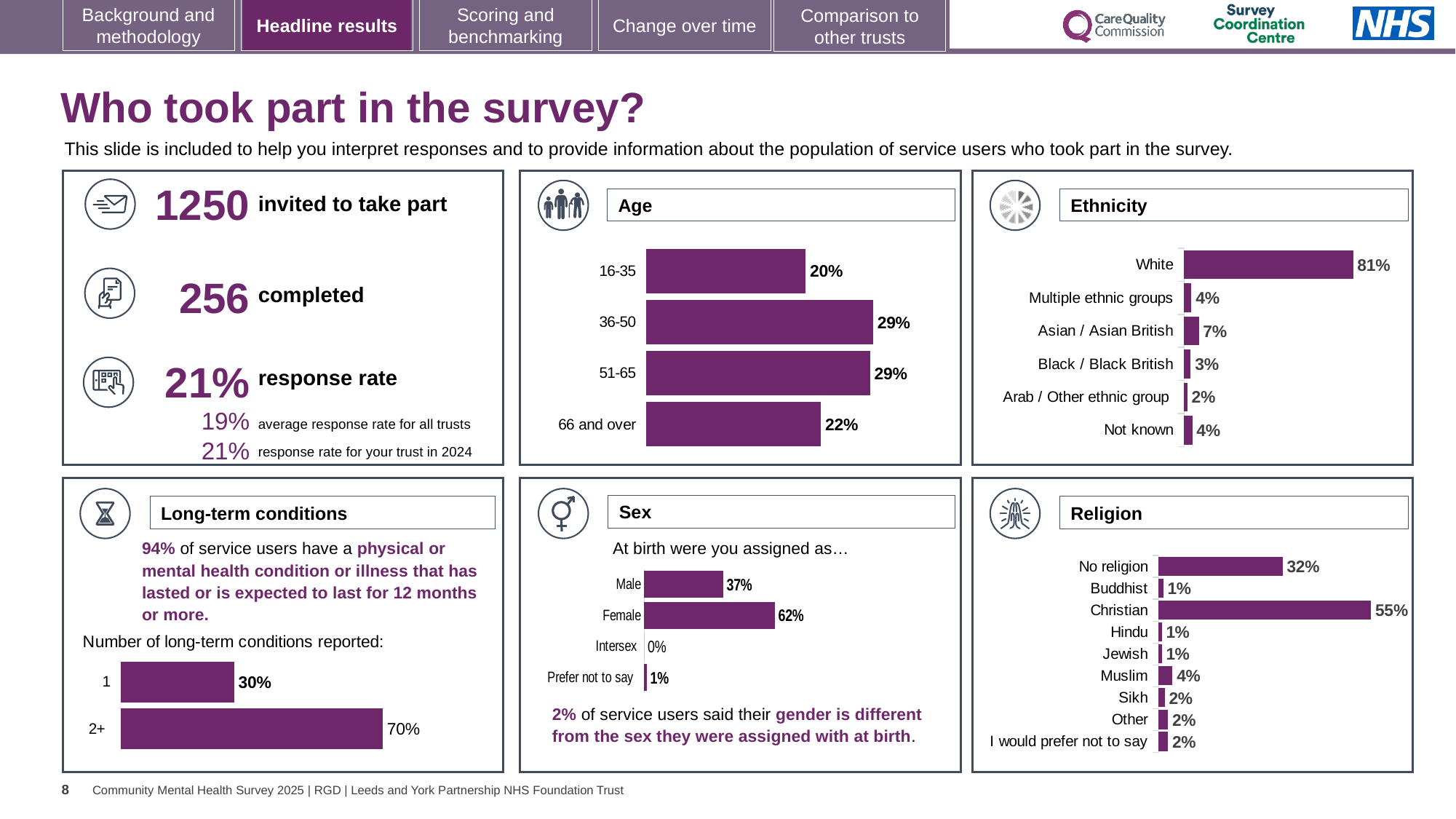
How many categories are shown in the Religion chart? 9 In the Religion chart, which category has the highest percentage? Christian In the Age chart, which age group has the lowest percentage? 16-35 In the Sex chart, which is larger, Male or Female? Female How many categories are shown in the Ethnicity chart? 6 In the Ethnicity chart, what percentage of respondents were White? 81% In the Ethnicity chart, what is the difference between the White and Asian / Asian British percentages? 74% In the Long-term conditions chart, what percentage of respondents reported 2+ conditions? 70% In the Age chart, what percentage of respondents were aged 36-50? 29% What type of chart is used in the Age panel? Bar chart In the Religion chart, what percentage of respondents reported No religion? 32% In the Sex chart, what percentage of respondents were assigned Female at birth? 62%